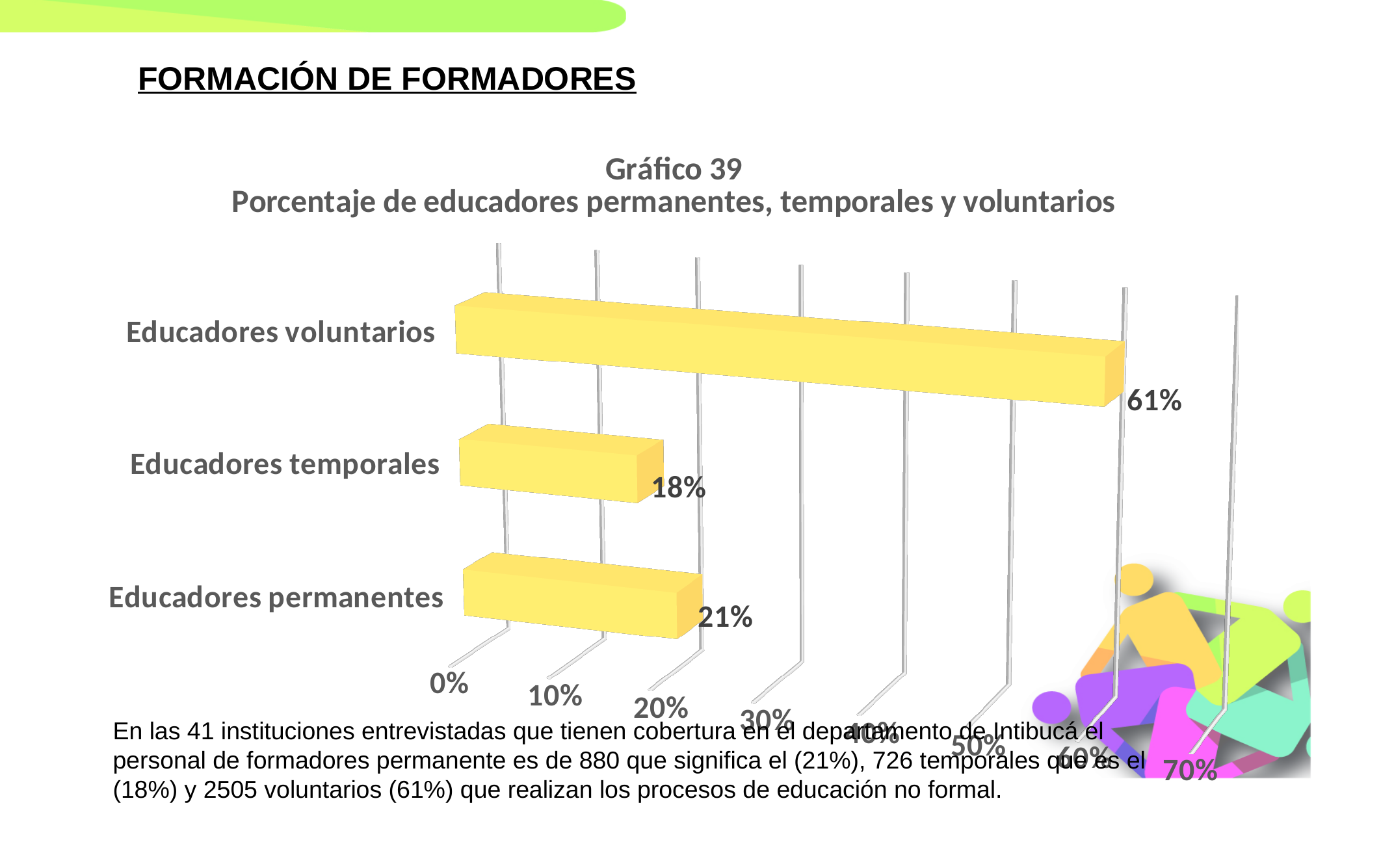
What kind of chart is shown on the slide? bar chart What is the difference between the values for Educadores voluntarios and Educadores permanentes? 40% Which is larger, the value for Educadores permanentes or Educadores temporales? Educadores permanentes What is the difference between the values for Educadores permanentes and Educadores temporales? 3% What is the title of the chart? Gráfico 39 Porcentaje de educadores permanentes, temporales y voluntarios Which category has the highest value? Educadores voluntarios Is the value for Educadores voluntarios greater or less than 50%? greater How many categories are shown in the chart? 3 Which category has the lowest value? Educadores temporales What is the value for Educadores voluntarios? 61% What is the value for Educadores permanentes? 21% What is the value for Educadores temporales? 18%